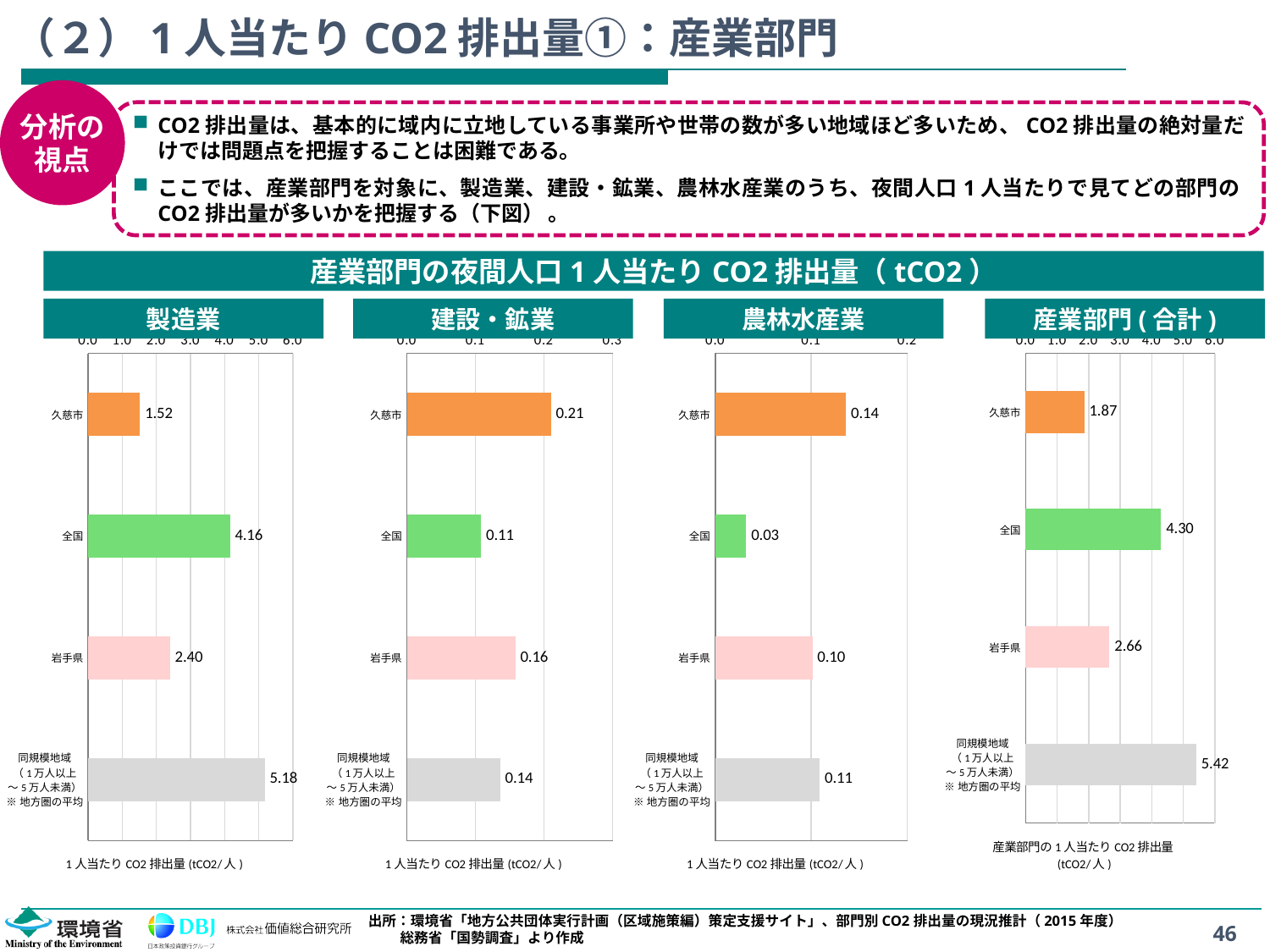
In the 農林水産業 chart, which category has the highest value? 久慈市 In the 農林水産業 chart, what is the value for 全国? 0.03 In the 産業部門(合計) chart, what is the difference between 全国 and 久慈市? 2.43 In the 建設・鉱業 chart, which is larger, 久慈市 or 同規模地域? 久慈市 How many categories are shown in the 産業部門(合計) chart? 4 What type of chart is the 製造業 chart? Bar chart In the 産業部門(合計) chart, what is the value for 同規模地域? 5.42 In the 建設・鉱業 chart, which category has the lowest value? 全国 In the 建設・鉱業 chart, what is the value for 岩手県? 0.16 In the 製造業 chart, what is the value for 久慈市? 1.52 In the 製造業 chart, what is the difference between 同規模地域 and 全国? 1.02 In the 製造業 chart, which category has the highest value? 同規模地域